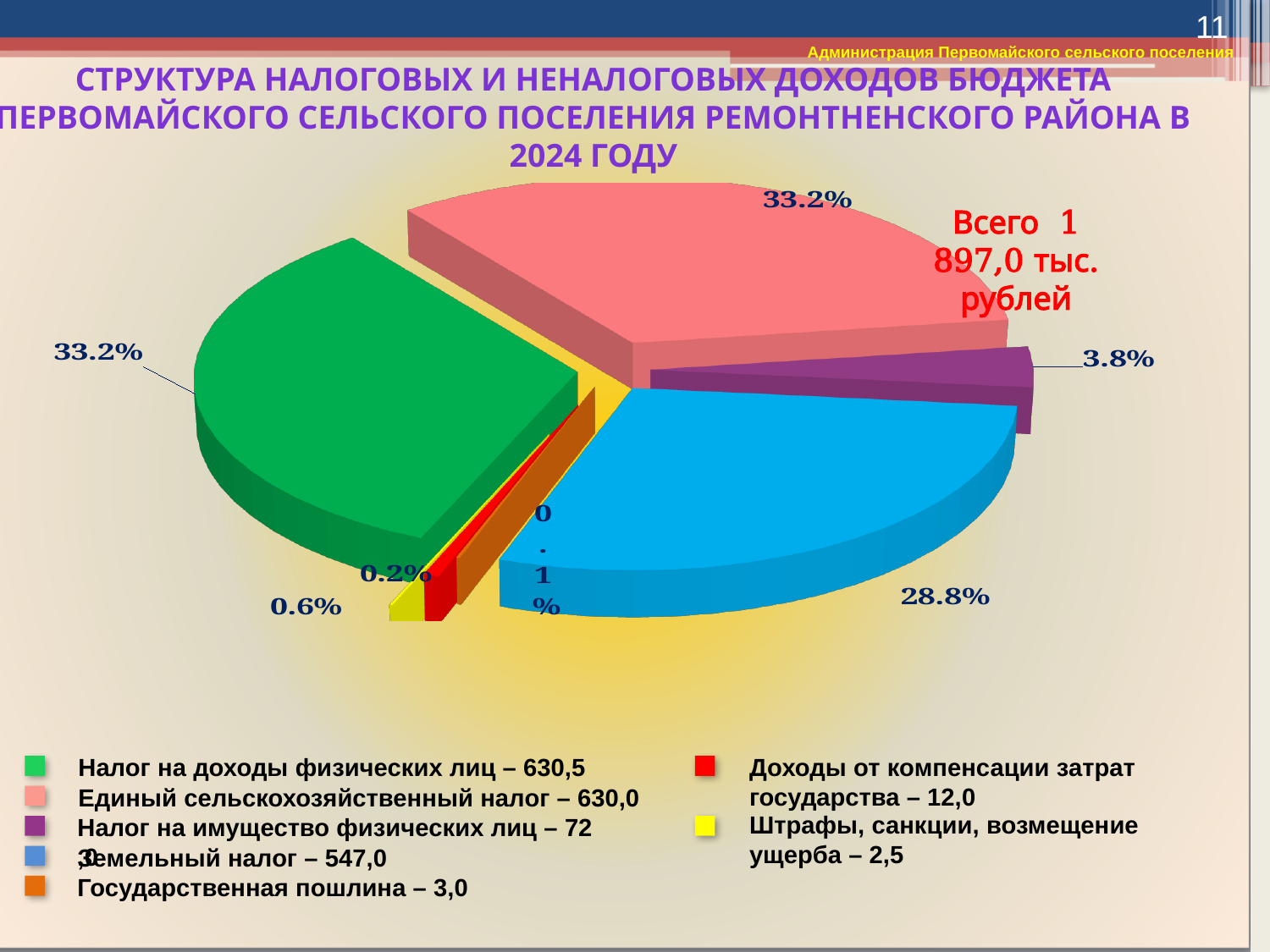
What value is given in the legend for Налог на доходы физических лиц? 630,5 What value is given in the legend for Доходы от компенсации затрат государства? 12,0 What kind of chart is shown on the slide? pie chart What share of the pie does Налог на имущество физических лиц have? 3.8% What is the difference between the legend values for Налог на доходы физических лиц and Земельный налог? 83,5 Which category has the smallest value according to the legend? Штрафы, санкции, возмещение ущерба Which is larger: Земельный налог or Налог на имущество физических лиц? Земельный налог How many categories does the legend of the pie chart list? 7 What total amount is stated next to the pie chart? 1 897,0 тыс. рублей What value is given in the legend for Единый сельскохозяйственный налог? 630,0 What share of the pie does Земельный налог have? 28.8% What value is given in the legend for Земельный налог? 547,0